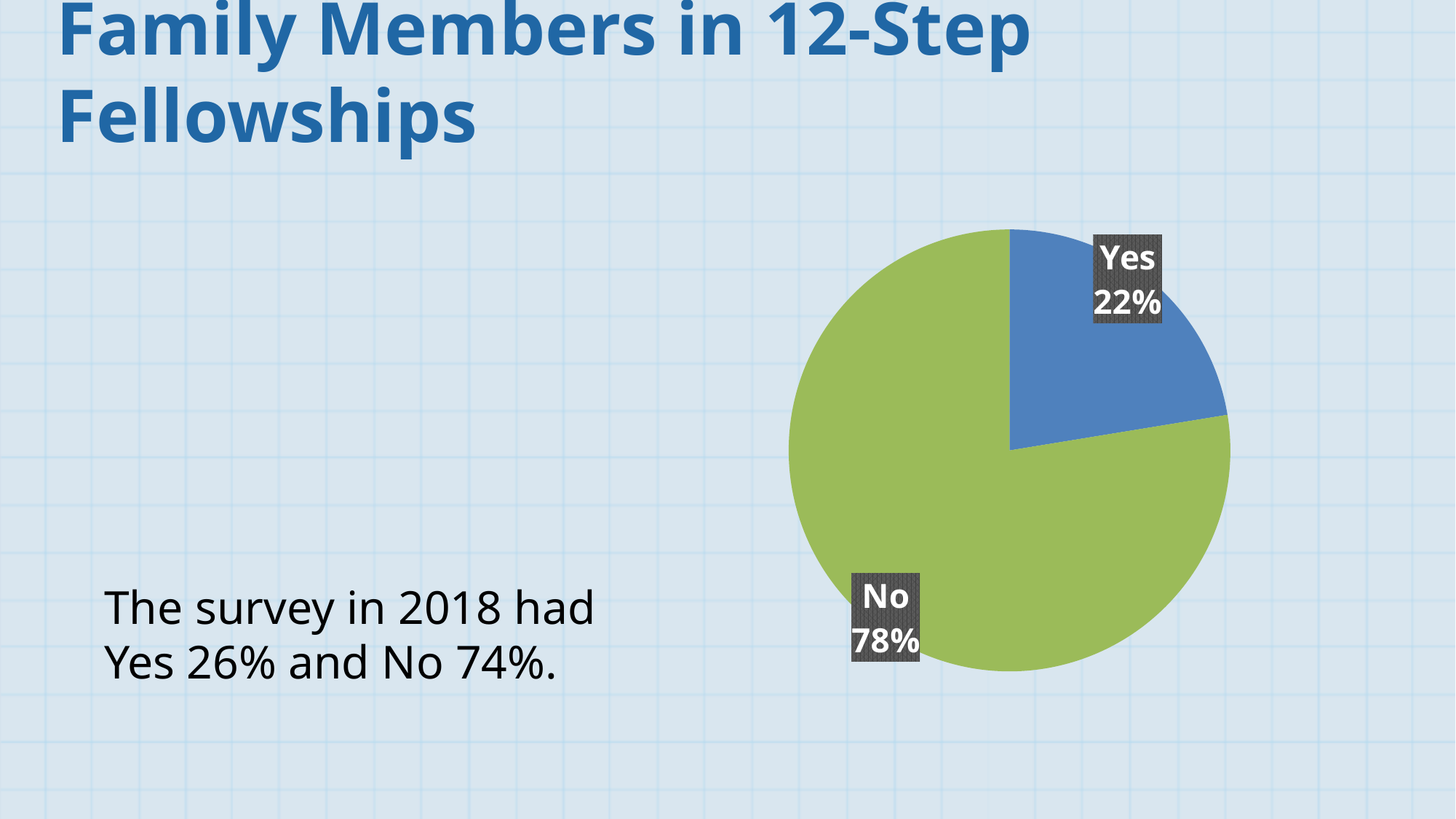
Which slice of the pie chart is the smallest? Yes What is the difference in percentage points between the "No" slice and the "Yes" slice? 56 What share of the pie does the "Yes" slice represent? 22% Which slice of the pie chart is the largest? No What percentage of the pie chart is labelled "Yes"? 22% How many slices does the pie chart have? 2 What colour is the "Yes" slice of the pie chart? Blue What kind of chart is shown on the slide? Pie chart Which slice is larger, "Yes" or "No"? No What colour is the "No" slice of the pie chart? Green What percentage of the pie chart is labelled "No"? 78%